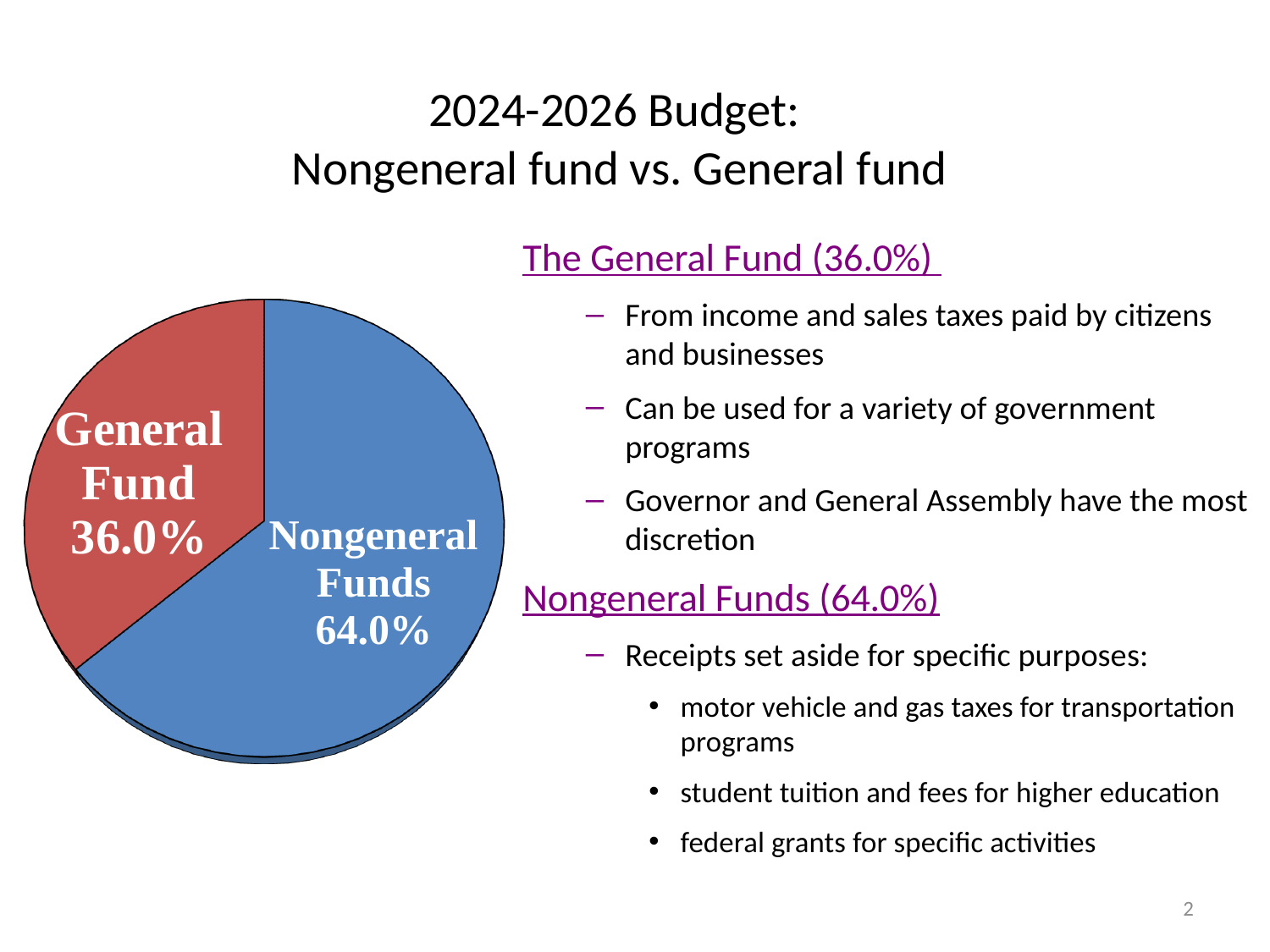
Which slice of the pie is the largest? Nongeneral Funds How many slices does the pie chart have? 2 What colour is the General Fund slice? Red What is the difference in percentage points between the Nongeneral Funds slice and the General Fund slice? 28.0% What colour is the Nongeneral Funds slice? Blue What kind of chart is shown on the slide? Pie chart Which is larger, the General Fund slice or the Nongeneral Funds slice? Nongeneral Funds Which slice of the pie is the smallest? General Fund What is the total of the two slices shown in the pie chart? 100.0% What share of the pie does the General Fund slice represent? 36.0% What share of the pie does the Nongeneral Funds slice represent? 64.0%